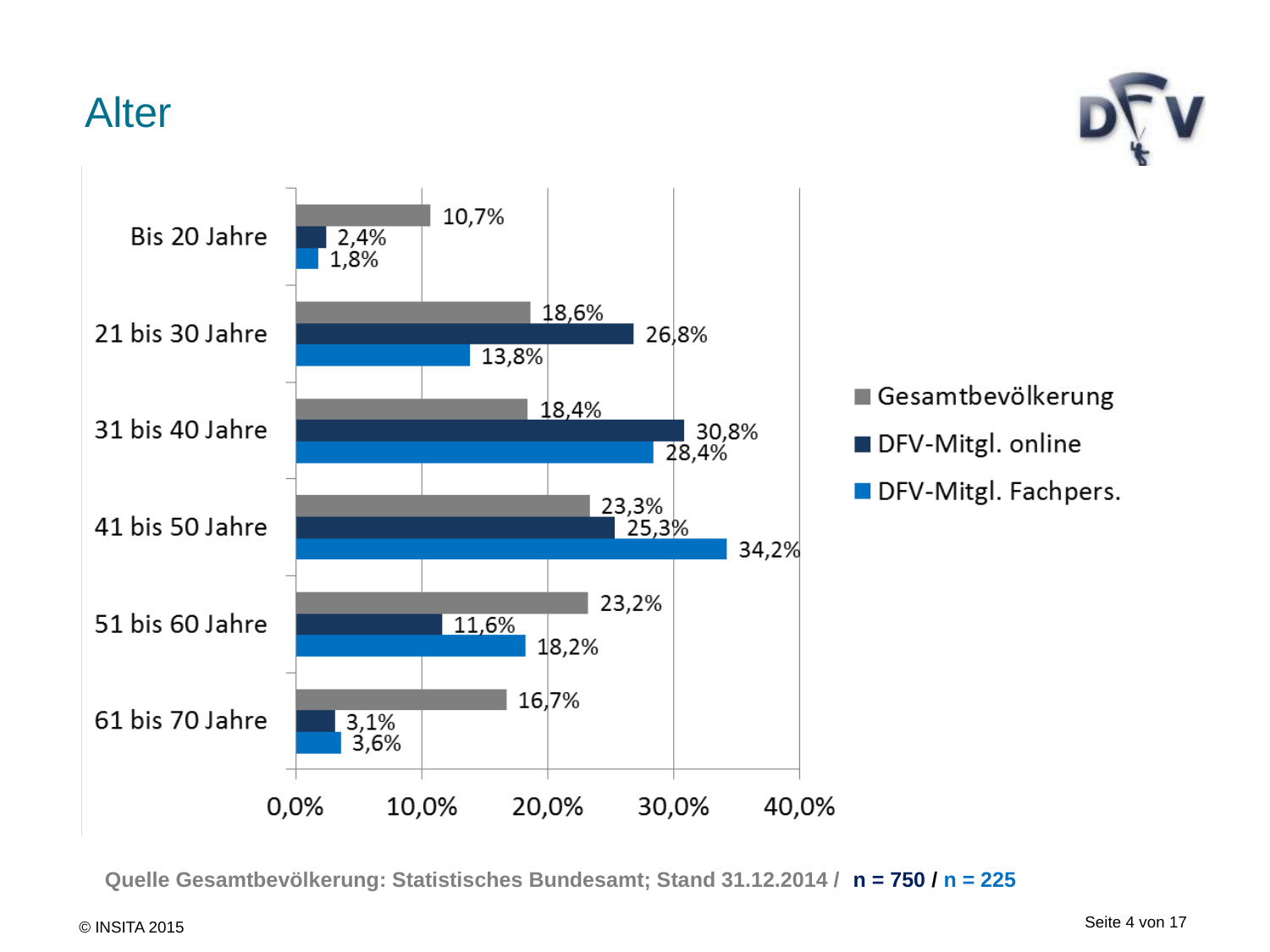
What is the difference between DFV-Mitgl. online and Gesamtbevölkerung in the 21 bis 30 Jahre category? 8,2% What is the value for Gesamtbevölkerung in the Bis 20 Jahre category? 10,7% Which age category has the highest value for DFV-Mitgl. Fachpers.? 41 bis 50 Jahre What kind of chart is shown on the slide? bar chart How many series does the legend list? 3 What is the value for DFV-Mitgl. online in the 31 bis 40 Jahre category? 30,8% Is the value for DFV-Mitgl. Fachpers. in the 41 bis 50 Jahre category greater or less than 30,0%? greater How many age categories are shown in the chart? 6 Which series is shown in gray in the legend? Gesamtbevölkerung What is the value for DFV-Mitgl. Fachpers. in the 51 bis 60 Jahre category? 18,2% In the 61 bis 70 Jahre category, which is larger: DFV-Mitgl. online or DFV-Mitgl. Fachpers.? DFV-Mitgl. Fachpers. Which age category has the lowest value for DFV-Mitgl. online? Bis 20 Jahre